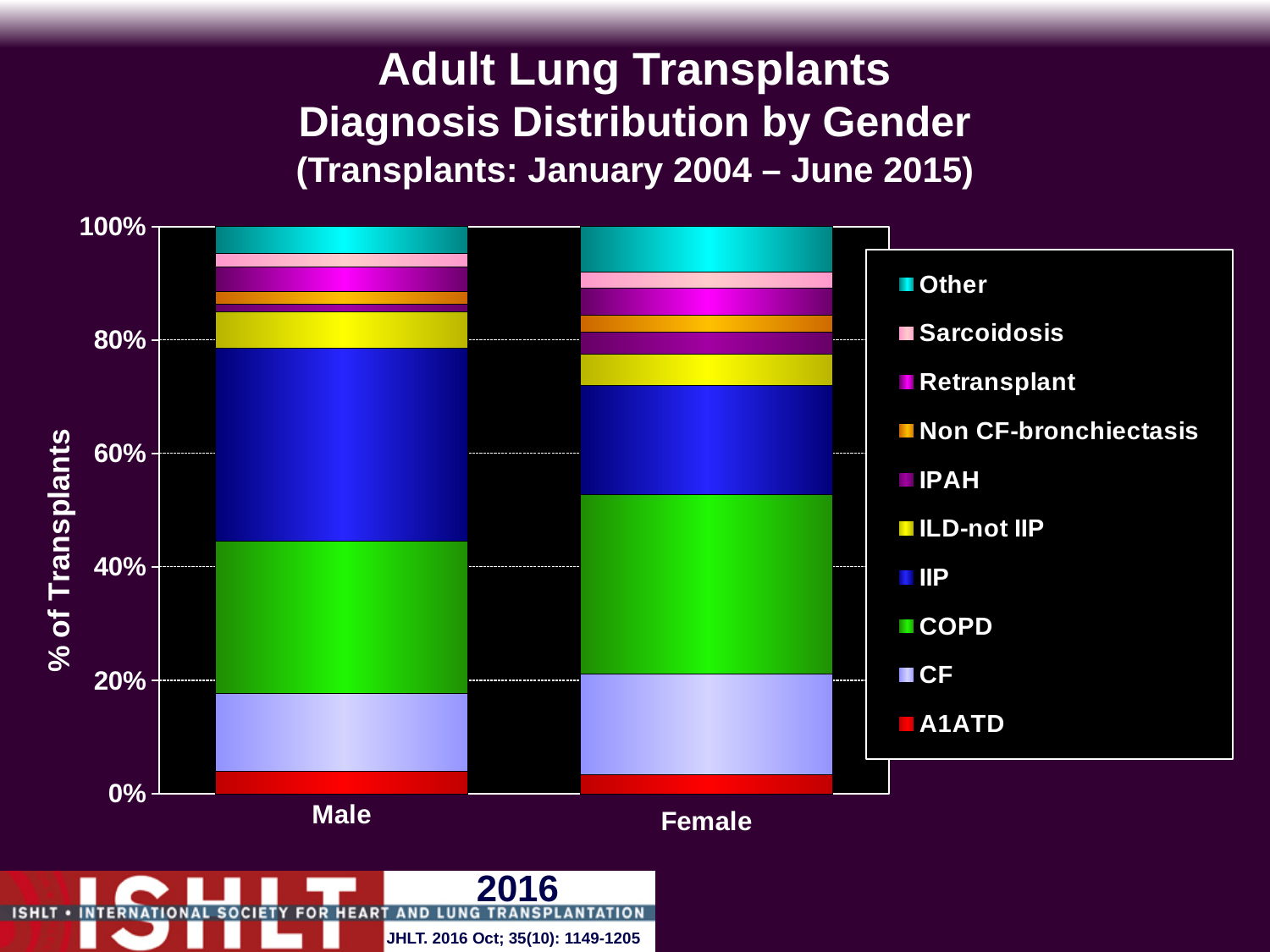
Which diagnosis is the largest segment in the Female bar? COPD Which diagnosis is the largest segment in the Male bar? IIP How many categories are shown on the x axis of the chart? 2 In the Male bar, is the top of the IIP segment greater or less than 80%? less Is the COPD share larger for Male or for Female? Female How many series does the legend list? 10 What does each stacked bar total? 100% What kind of chart is shown on the slide? Stacked bar chart What is the label of the y axis? % of Transplants What is the title of the chart? Adult Lung Transplants Diagnosis Distribution by Gender (Transplants: January 2004 – June 2015) Is the IIP share larger for Male or for Female? Male Is the 'Other' share larger for Male or for Female? Female